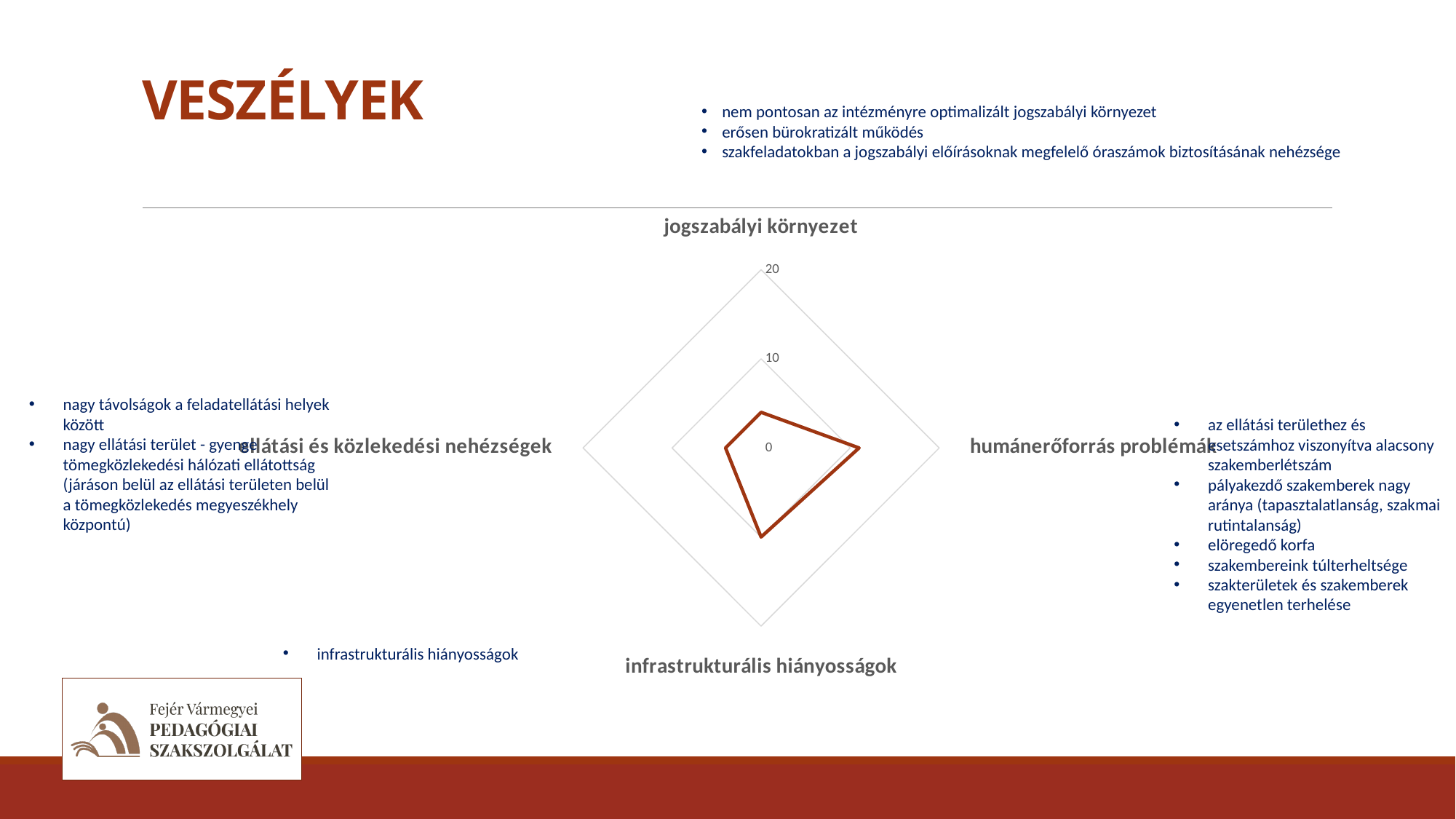
Is the value for ellátási és közlekedési nehézségek greater or less than 10? less Which category is placed at the top of the radar chart? jogszabályi környezet Is the value for humánerőforrás problémák greater or less than 20? less Is the value for jogszabályi környezet greater or less than 10? less What kind of chart is shown on the slide? radar chart Which is larger, the value for humánerőforrás problémák or the value for jogszabályi környezet? humánerőforrás problémák How many categories (axes) does the radar chart have? 4 What is the highest tick value shown on the radar chart's axis? 20 Which is larger, the value for infrastrukturális hiányosságok or the value for ellátási és közlekedési nehézségek? infrastrukturális hiányosságok